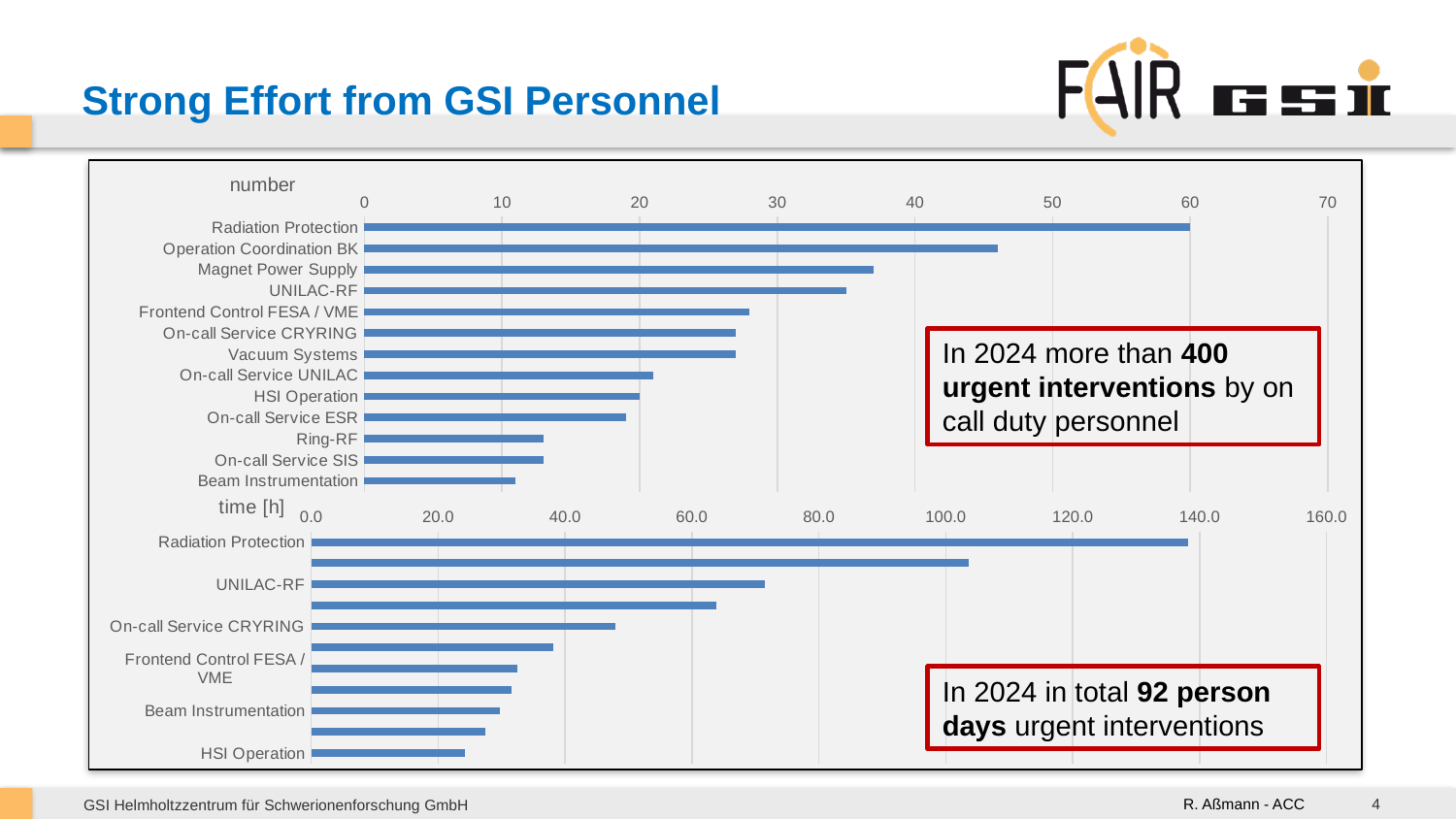
In the top chart labelled "number", how many categories are shown? 13 In the top chart labelled "number", is the value for Operation Coordination BK greater or less than 40? greater What is the axis label shown at the top left of the bottom chart? time [h] In the top chart labelled "number", which category has the highest value? Radiation Protection What kind of chart is the top chart labelled "number"? bar chart In the top chart labelled "number", is the value for Ring-RF greater or less than 20? less In the bottom chart labelled "time [h]", is the value for HSI Operation greater or less than 40.0? less In the bottom chart labelled "time [h]", which category has the highest value? Radiation Protection In the top chart labelled "number", which category has the lowest value? Beam Instrumentation In the bottom chart labelled "time [h]", which is larger: On-call Service CRYRING or Beam Instrumentation? On-call Service CRYRING In the top chart labelled "number", which is larger: Magnet Power Supply or HSI Operation? Magnet Power Supply